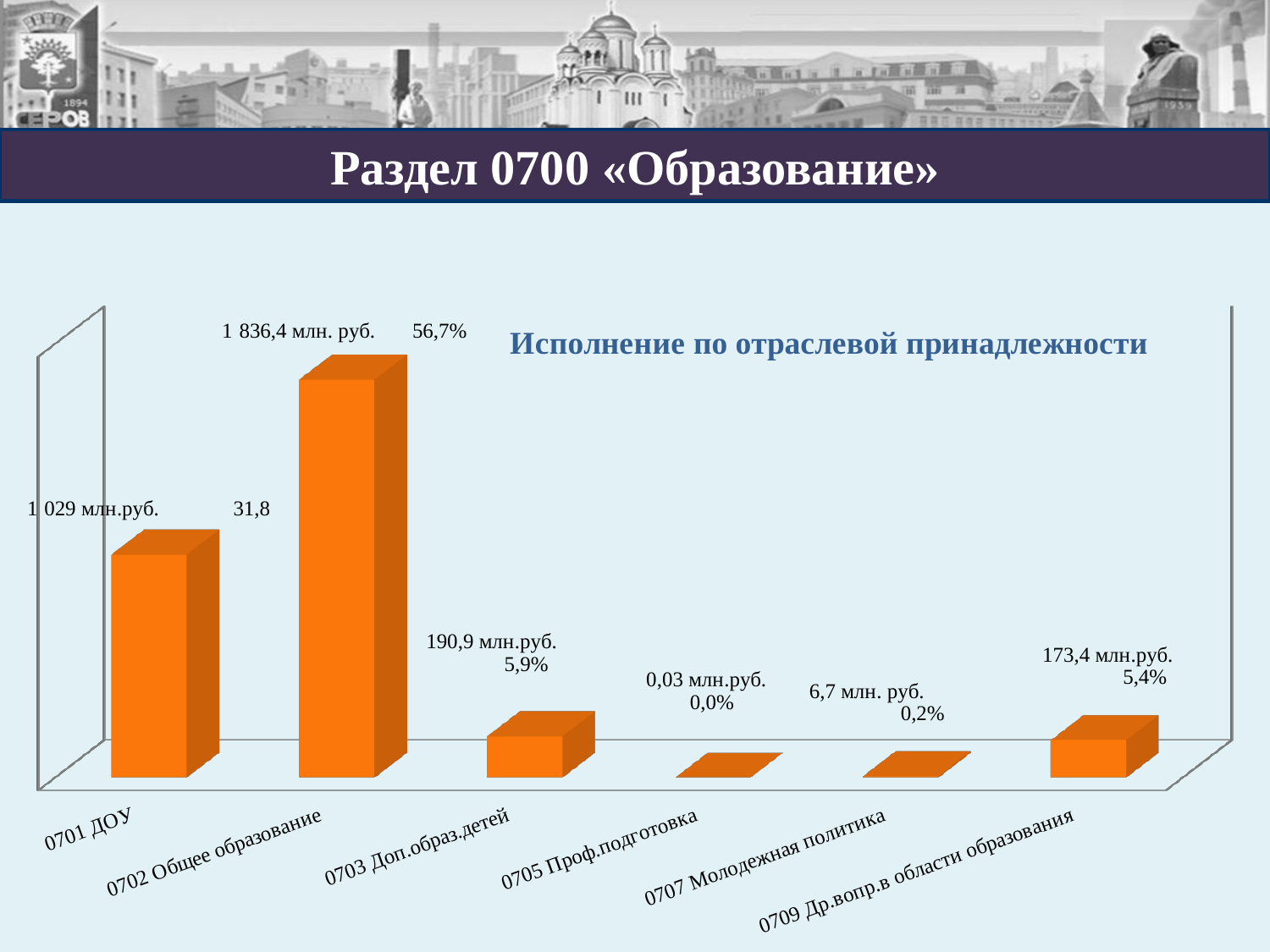
What percentage is shown for 0705 Проф.подготовка? 0,0% Which category has the lowest value? 0705 Проф.подготовка What is the difference between the values for 0702 Общее образование and 0701 ДОУ, in млн. руб.? 807,4 Which is larger, the value for 0703 Доп.образ.детей or for 0709 Др.вопр.в области образования? 0703 Доп.образ.детей What value is shown for 0707 Молодежная политика? 6,7 млн. руб. What value is shown for 0701 ДОУ? 1 029 млн.руб. Which category has the highest value? 0702 Общее образование What is the title of the chart? Исполнение по отраслевой принадлежности What value is shown for 0702 Общее образование? 1 836,4 млн. руб. How many categories are shown on the chart? 6 What percentage is shown for 0709 Др.вопр.в области образования? 5,4% What value is shown for 0703 Доп.образ.детей? 190,9 млн.руб.